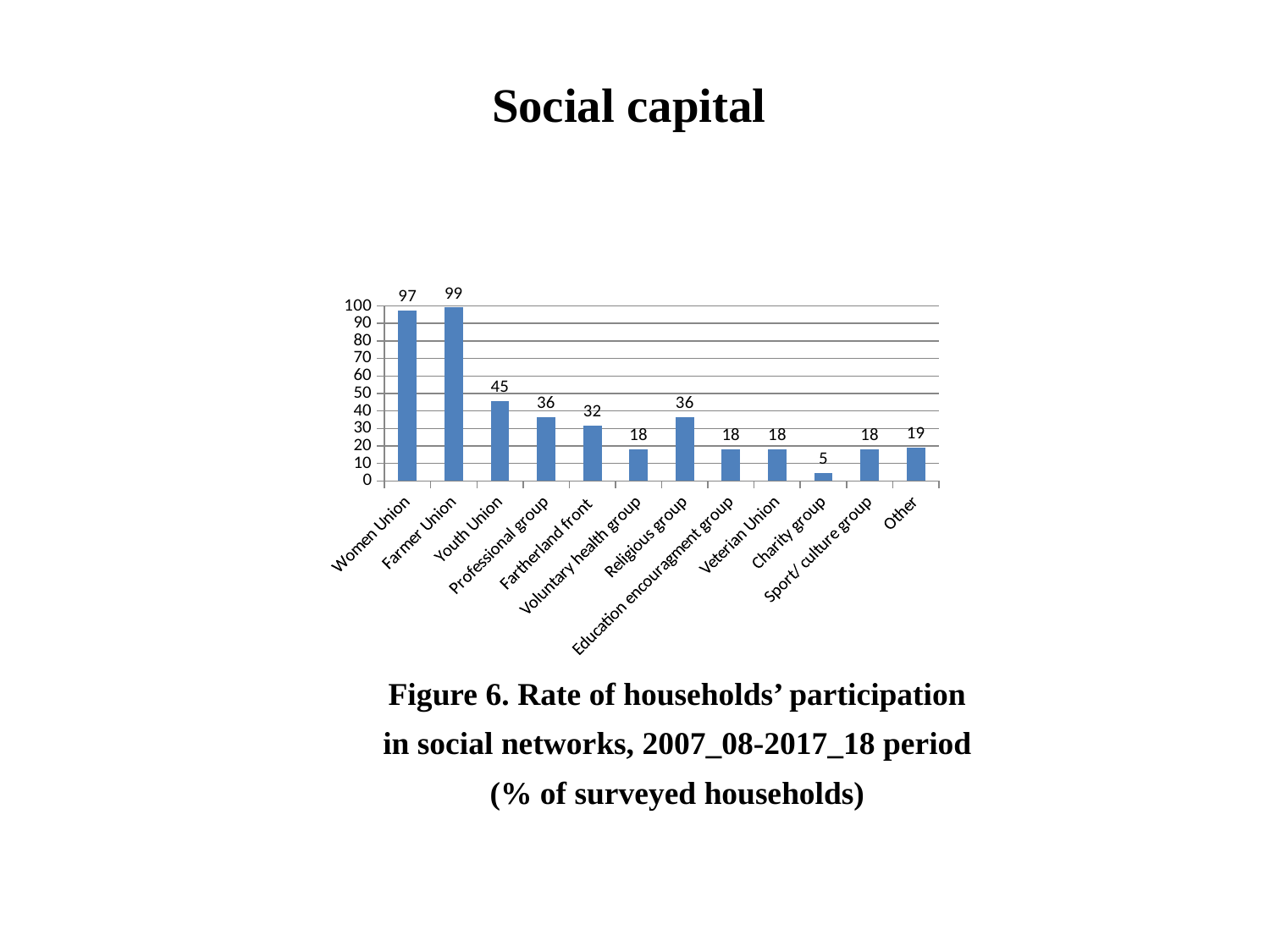
What is the value for Farmer Union? 99 Which category has the highest value? Farmer Union What is the difference between the values for Religious group and Other? 17 How many categories are shown on the x axis? 12 What is the value for Youth Union? 45 What is the difference between the values for Women Union and Youth Union? 52 Which category has the lowest value? Charity group What kind of chart is shown on the slide? Bar chart What is the value for Fartherland front? 32 Which is larger, the value for Professional group or the value for Veterian Union? Professional group What is the title of the slide above the chart? Social capital What is the value for Charity group? 5